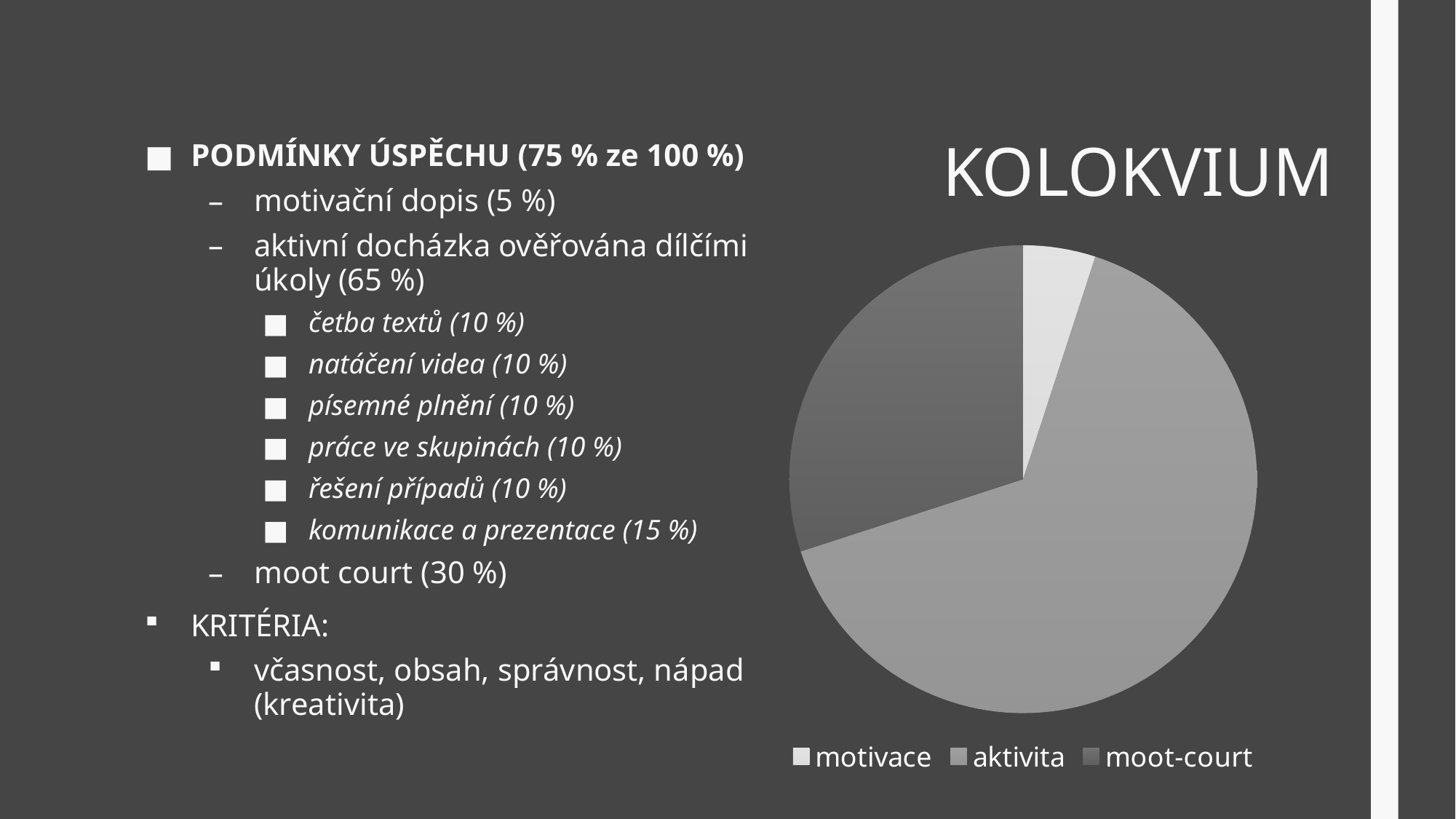
What kind of chart is shown on the slide? pie chart Which slice is larger, aktivita or moot-court? aktivita What is the title of the chart? KOLOKVIUM How many slices does the pie chart have? 3 What are the legend entries of the chart, in order? motivace, aktivita, moot-court Which category has the smallest slice of the pie? motivace Which category has the largest slice of the pie? aktivita How many entries does the chart legend list? 3 Which slice is larger, moot-court or motivace? moot-court